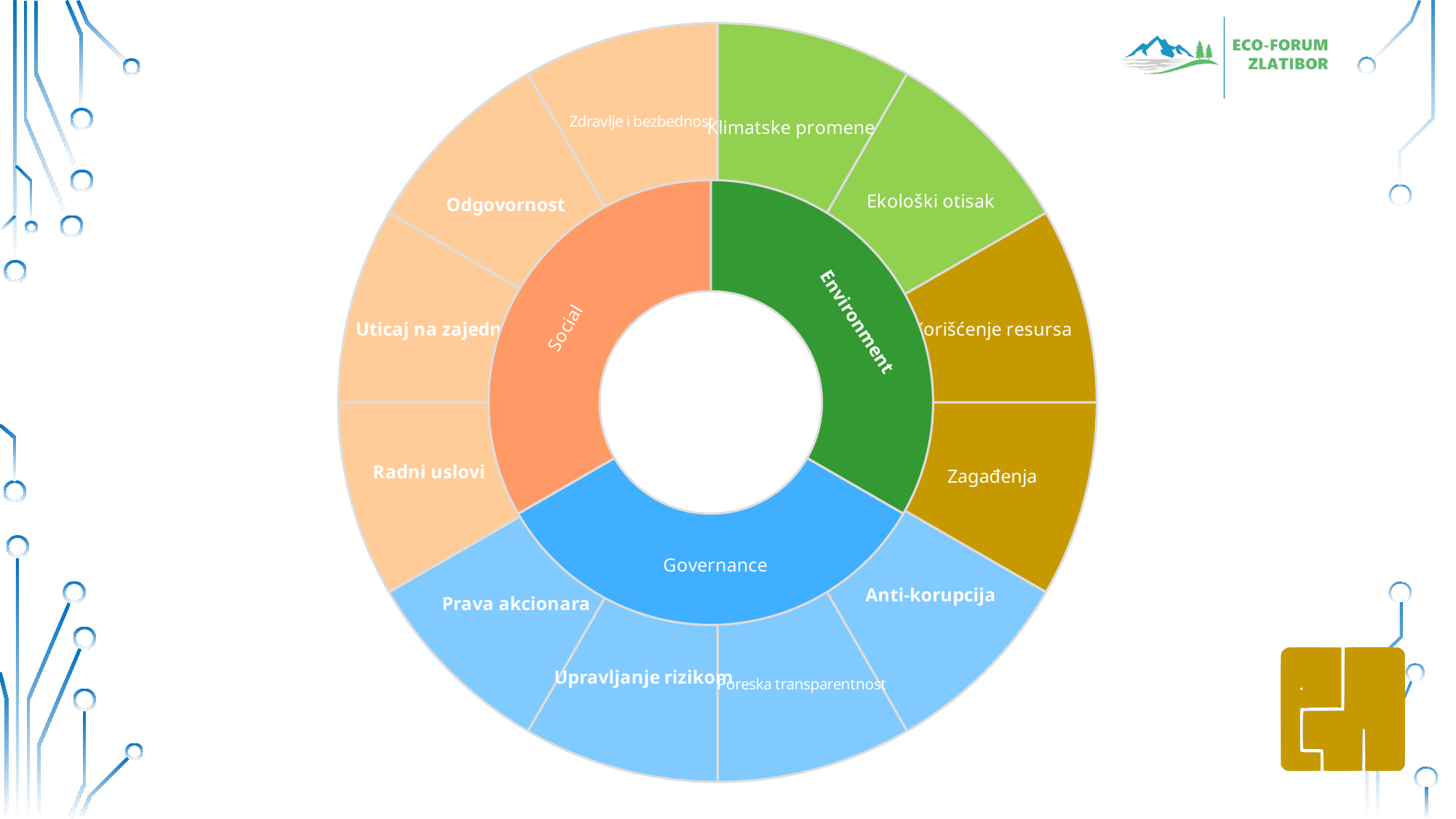
Which inner-ring category does the outer segment 'Zagađenja' belong to? Environment Which inner-ring category does the outer segment 'Poreska transparentnost' belong to? Governance Which inner-ring category does the outer segment 'Radni uslovi' belong to? Social What are the three labels in the inner ring of the chart? Environment, Social, Governance How many outer-ring segments belong to the Environment category? 4 How many segments are in the inner ring of the chart? 3 What kind of chart is shown on the slide? Sunburst chart Which inner-ring category does the outer segment 'Ekološki otisak' belong to? Environment How many outer-ring segments belong to the Governance category? 4 Which inner-ring category does the outer segment 'Anti-korupcija' belong to? Governance What colour is the Governance segment in the inner ring? Blue